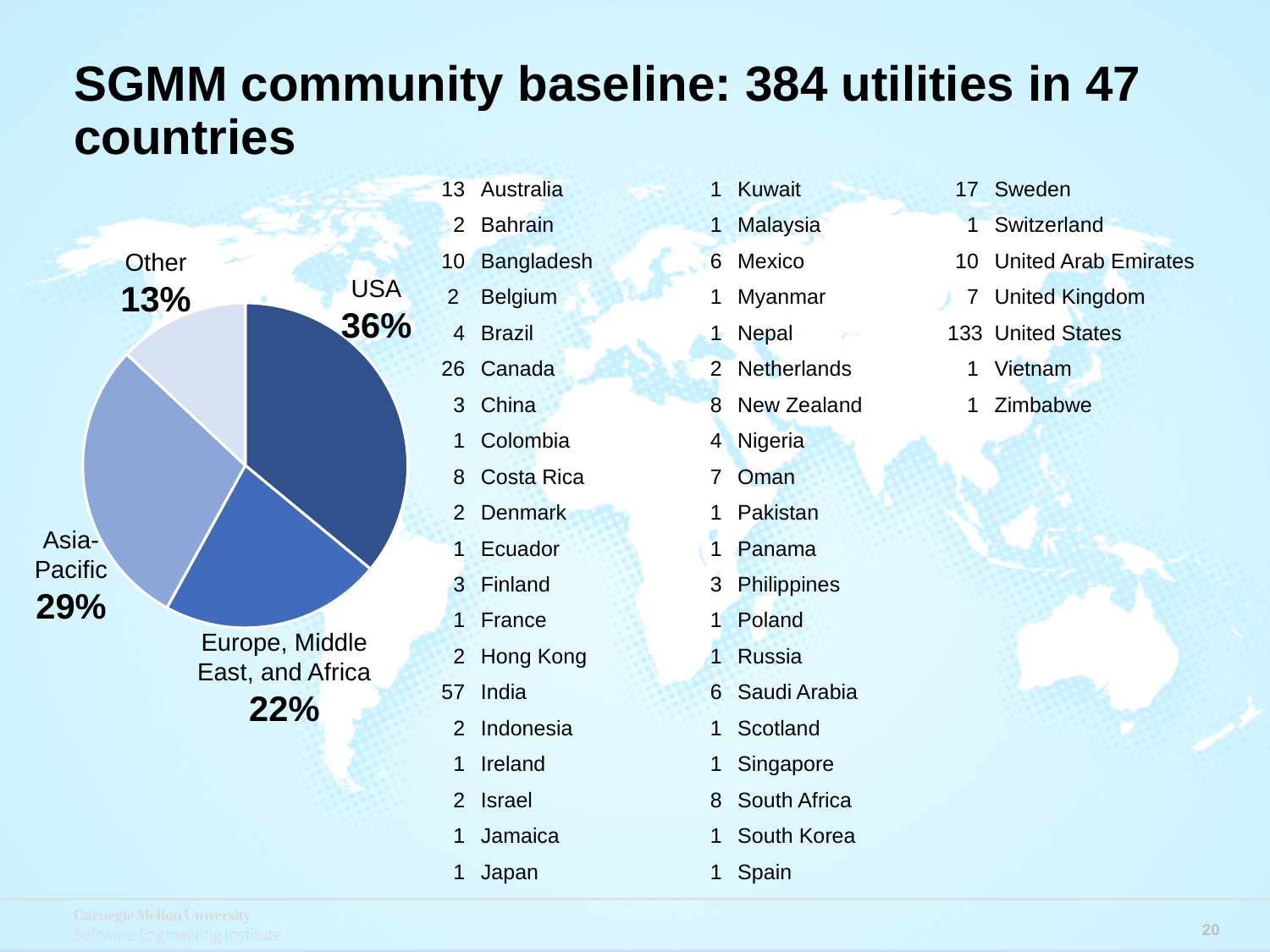
What is the difference in percentage points between the Europe, Middle East, and Africa slice and the Other slice? 9 How many slices does the pie chart have? 4 Which slice of the pie chart is the smallest? Other What share of the pie does Europe, Middle East, and Africa represent? 22% Which is larger in the pie chart, Asia-Pacific or Europe, Middle East, and Africa? Asia-Pacific What share of the pie does Asia-Pacific represent? 29% What is the difference in percentage points between the USA slice and the Asia-Pacific slice? 7 Which slice of the pie chart is the largest? USA What share of the pie does Other represent? 13% What kind of chart is shown on the slide? pie chart What share of the pie does USA represent? 36% What is the title of the slide containing the pie chart? SGMM community baseline: 384 utilities in 47 countries